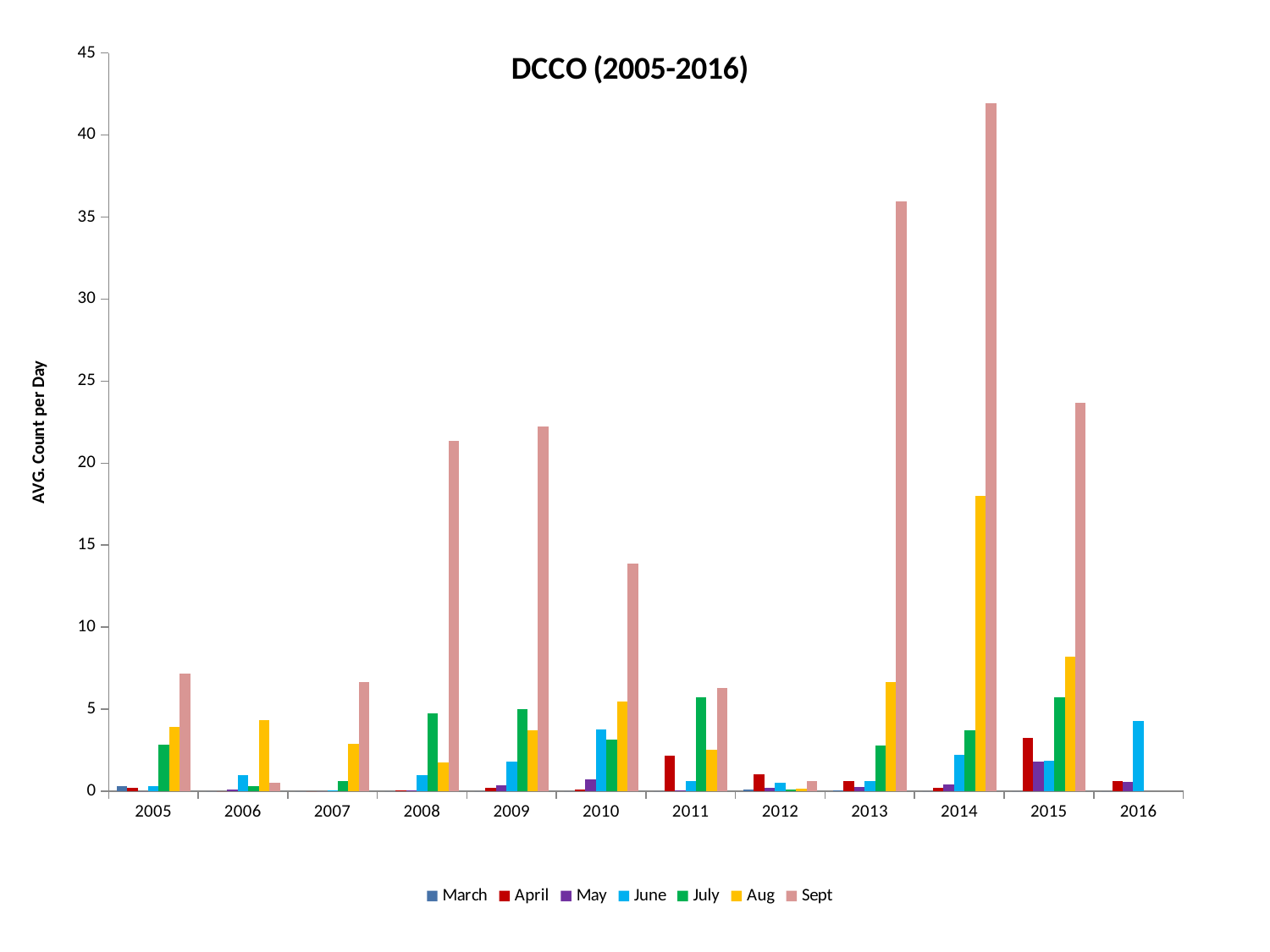
Is the Aug value for 2014 greater or less than 15? greater What kind of chart is shown on the slide? bar chart Which is larger, the Sept value for 2013 or the Sept value for 2015? 2013 In which year is the Sept value highest? 2014 Is the Sept value for 2014 greater or less than 40? greater Which is larger, the Aug value for 2014 or the Aug value for 2015? 2014 What is the title of the chart? DCCO (2005-2016) How many series does the legend list? 7 Is the Sept value for 2015 greater or less than 20? greater What is the label on the vertical axis? AVG. Count per Day How many years are shown along the x axis? 12